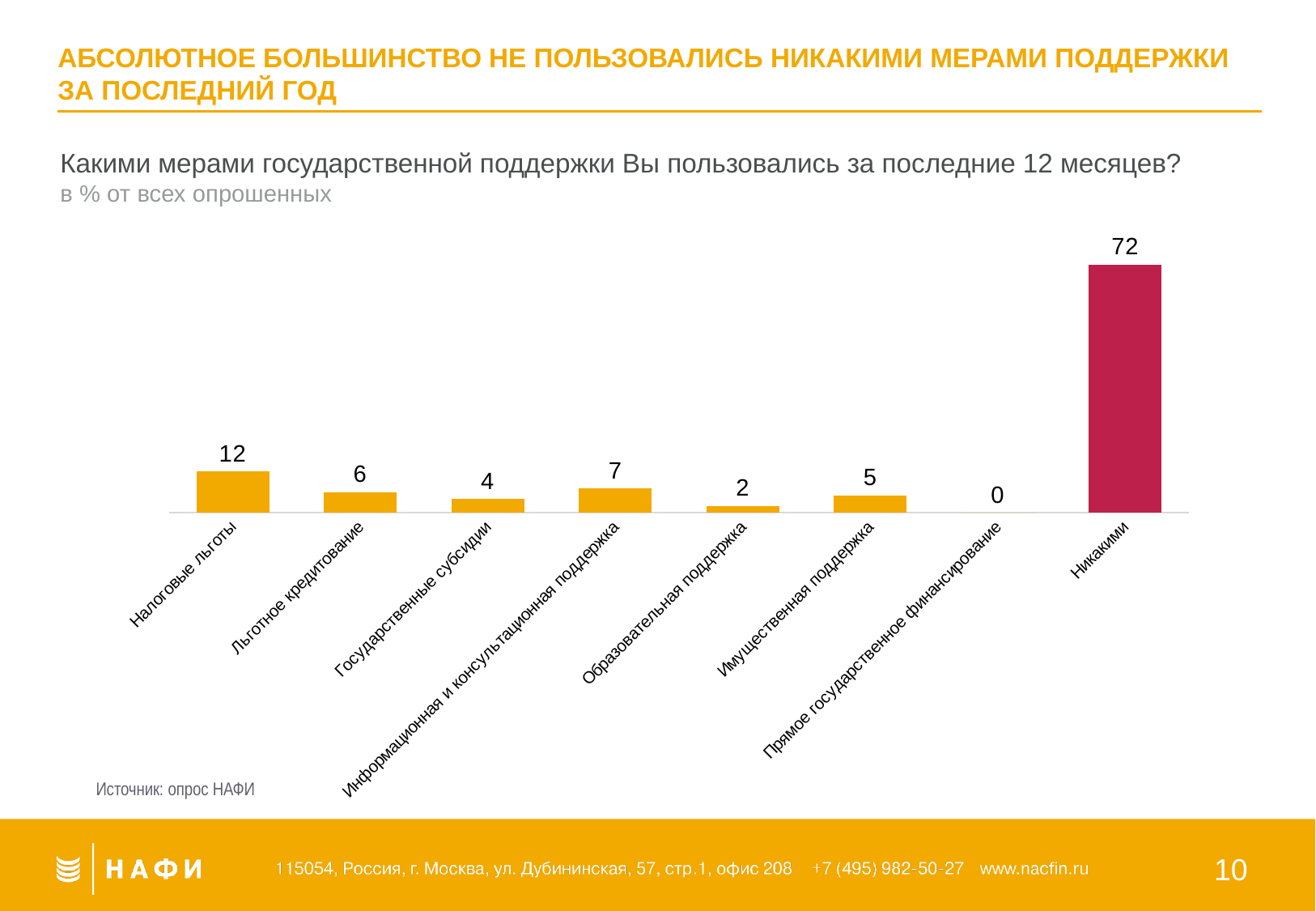
What is the value for Налоговые льготы? 12 Which category has the highest value? Никакими Which category has the lowest value? Прямое государственное финансирование What is the difference between the values for Никакими and Налоговые льготы? 60 What colour is the bar for Никакими? dark red What is the value for Информационная и консультационная поддержка? 7 What kind of chart is shown on the slide? bar chart What is the difference between the values for Льготное кредитование and Государственные субсидии? 2 What is the value for Прямое государственное финансирование? 0 How many categories are shown in the chart? 8 Which is larger, the value for Имущественная поддержка or the value for Образовательная поддержка? Имущественная поддержка What is the value for Никакими? 72